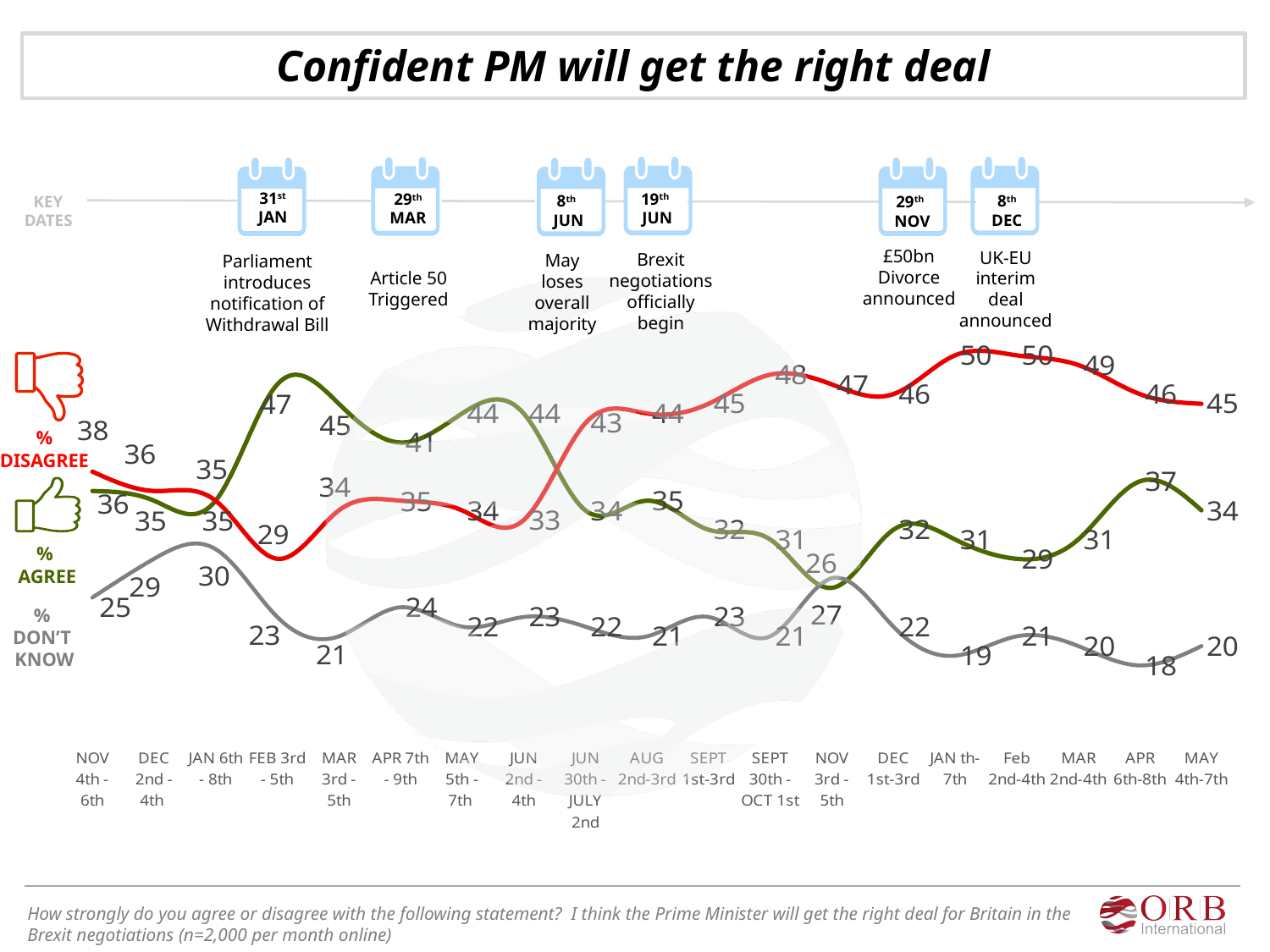
What is the % AGREE value for APR 6th-8th? 37 What is the % DISAGREE value for FEB 3rd - 5th? 29 What type of chart is shown on the slide? Line chart How many survey dates are plotted along the x axis? 19 At which survey date is % DISAGREE at its lowest? FEB 3rd - 5th What is the % DON'T KNOW value for NOV 3rd - 5th? 27 What key date is labelled 'Article 50 Triggered'? 29th MAR How many series are plotted on the chart? 3 At which survey date is % DON'T KNOW at its lowest? APR 6th-8th What is the difference between % DISAGREE and % AGREE at MAY 4th-7th? 11 At which survey date does % AGREE reach its highest value? FEB 3rd - 5th Which is larger at JUN 2nd - 4th, % AGREE or % DISAGREE? % AGREE